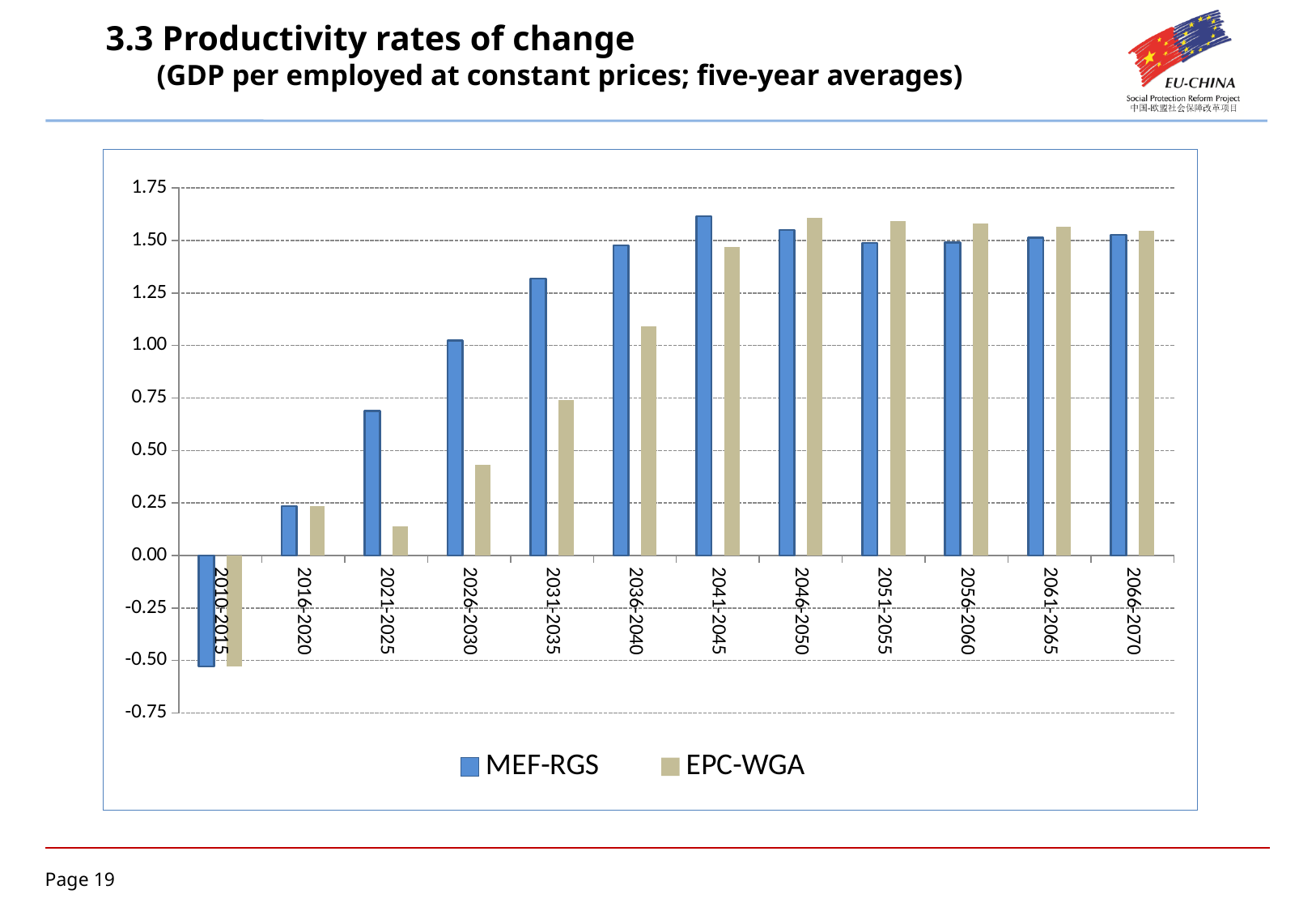
For 2031-2035, which series has the larger value, MEF-RGS or EPC-WGA? MEF-RGS Is the MEF-RGS value for 2021-2025 greater or less than 0.75? less What kind of chart is shown on the slide? bar chart Do the EPC-WGA values rise or fall from 2021-2025 to 2046-2050? rise Which period has the lowest EPC-WGA value? 2010-2015 How many series does the legend list? 2 Is the EPC-WGA value for 2021-2025 greater or less than 0.25? less For 2046-2050, which series has the larger value, MEF-RGS or EPC-WGA? EPC-WGA How many five-year periods are shown on the x axis? 12 Which period has the lowest MEF-RGS value? 2010-2015 Is the EPC-WGA value for 2036-2040 greater or less than 1.00? greater Which period has the highest MEF-RGS value? 2041-2045